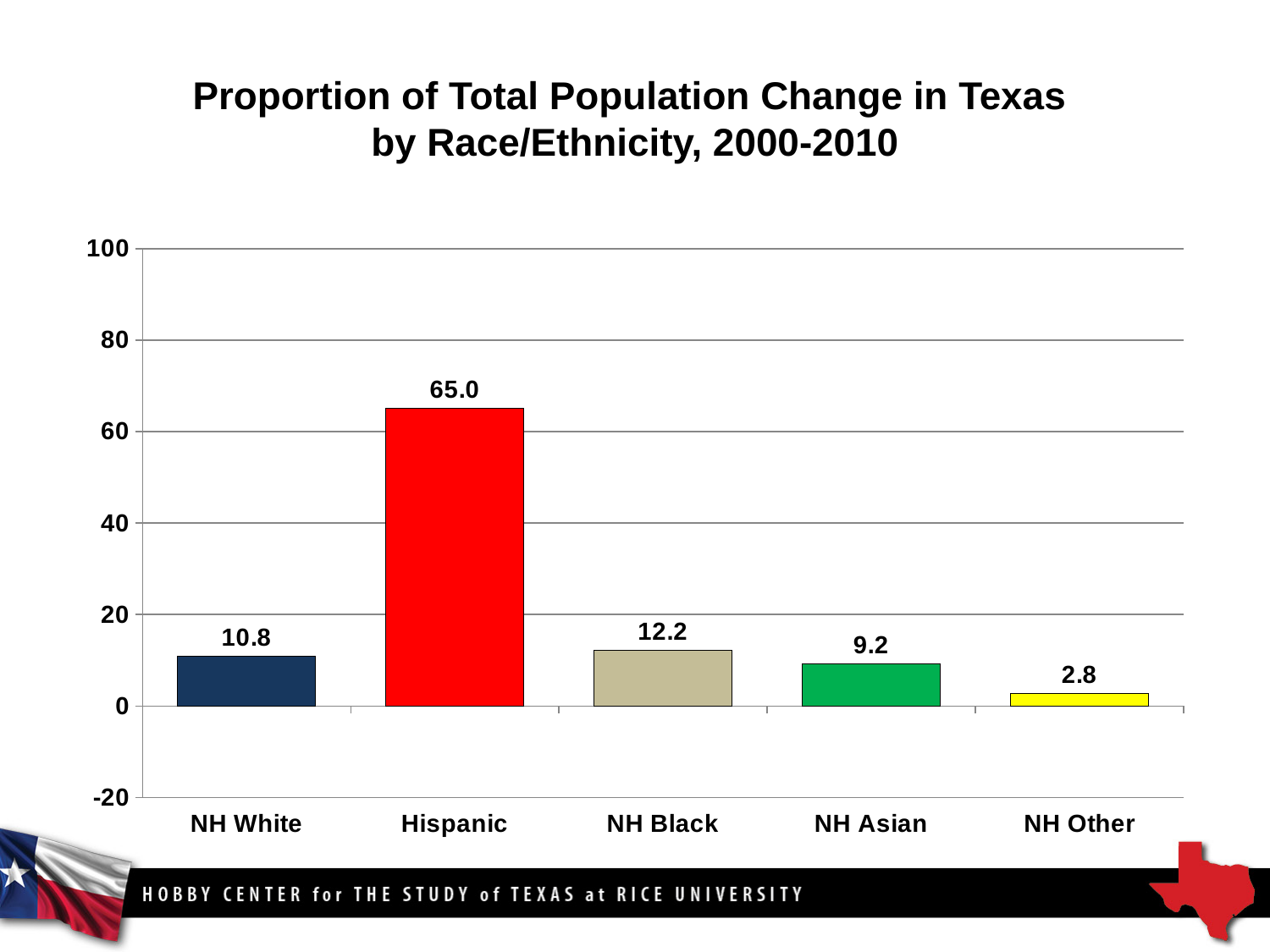
What is the difference between the values for Hispanic and NH Black? 52.8 Which category has the lowest value? NH Other Which is larger, the value for NH White or the value for NH Asian? NH White How many categories are shown on the x axis? 5 What is the value for NH White? 10.8 Which category has the highest value? Hispanic What kind of chart is shown on the slide? bar chart What is the value for Hispanic? 65.0 Is the value for Hispanic greater or less than 60? greater What is the title of the chart? Proportion of Total Population Change in Texas by Race/Ethnicity, 2000-2010 What is the value for NH Other? 2.8 What is the difference between the values for NH Black and NH Asian? 3.0